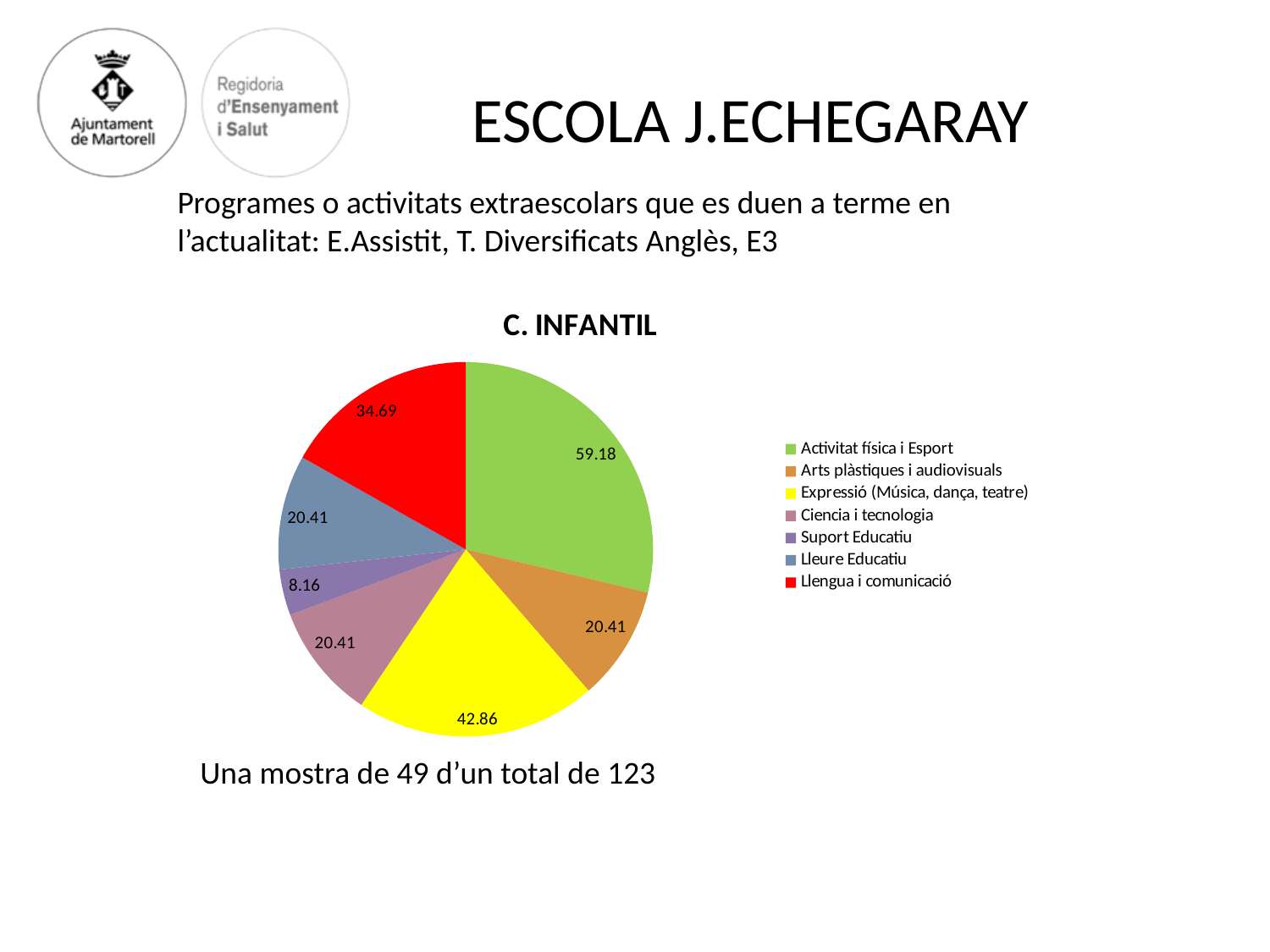
How many slices does the pie chart have? 7 What is the value for Llengua i comunicació? 34.69 What is the difference between the values for Activitat física i Esport and Expressió (Música, dança, teatre)? 16.32 What is the title of the chart? C. INFANTIL What is the value for Expressió (Música, dança, teatre)? 42.86 Which category has the lowest value? Suport Educatiu What is the value for Activitat física i Esport? 59.18 Which category has the highest value? Activitat física i Esport Which is larger, the value for Llengua i comunicació or the value for Lleure Educatiu? Llengua i comunicació What type of chart is shown on the slide? pie chart What is the value for Suport Educatiu? 8.16 How many entries does the legend list? 7